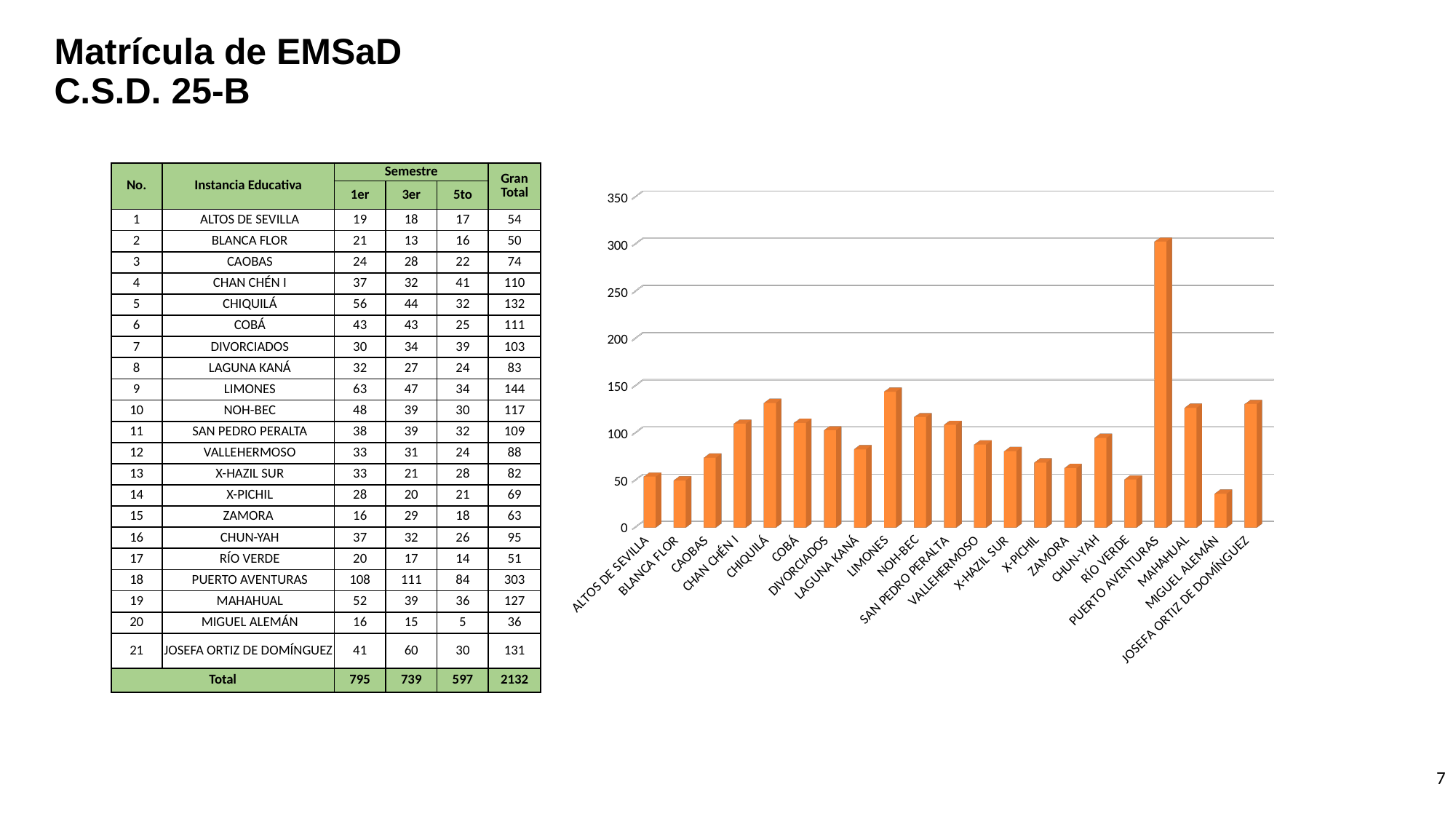
What is the highest tick value shown on the chart's vertical axis? 350 Is the value for MIGUEL ALEMÁN in the chart greater or less than 50? less How many instancias educativas (categories) are plotted on the x axis of the chart? 21 Which instancia educativa has the lowest bar in the chart? MIGUEL ALEMÁN Using the Gran Total values in the table, what is the difference between the bars for PUERTO AVENTURAS and MAHAHUAL? 176 Is the value for ZAMORA in the chart greater or less than 100? less What kind of chart is shown on the slide? bar chart According to the Gran Total column of the table, what value is plotted for PUERTO AVENTURAS in the chart? 303 Which has the taller bar in the chart, CHAN CHÉN I or CAOBAS? CHAN CHÉN I Is the value for LIMONES in the chart greater or less than 100? greater Which instancia educativa has the highest bar in the chart? PUERTO AVENTURAS